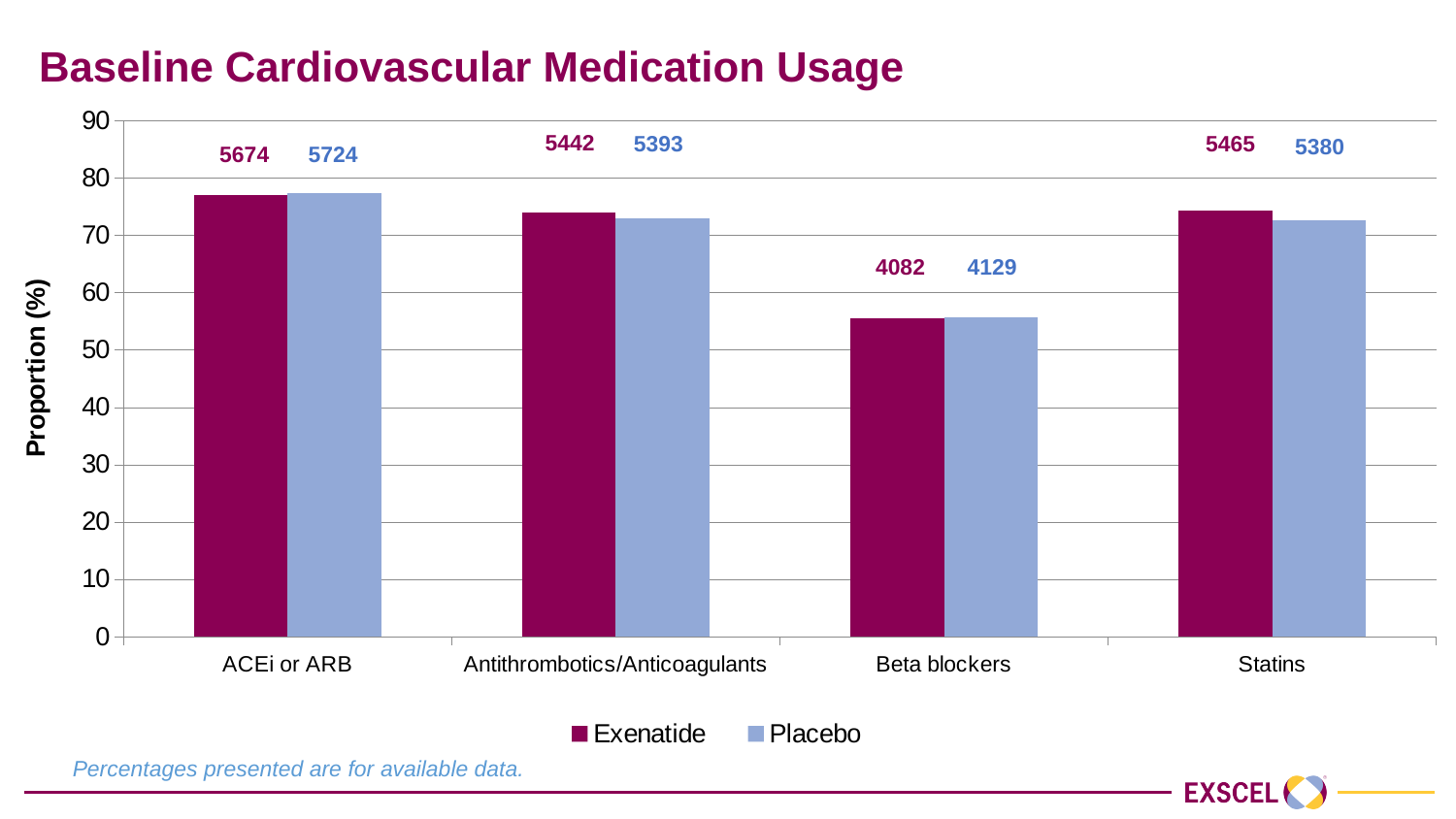
What is the title of the chart? Baseline Cardiovascular Medication Usage What number is printed above the Exenatide bar for ACEi or ARB? 5674 Is the Placebo proportion for ACEi or ARB greater or less than 70? greater Which category has the lowest proportion for the Exenatide series? Beta blockers How many medication categories are shown on the x axis? 4 Is the Exenatide proportion for Beta blockers greater or less than 60? less What number is printed above the Exenatide bar for Statins? 5465 What is the label on the y axis? Proportion (%) Which category has the highest proportion for the Placebo series? ACEi or ARB What kind of chart is shown on the slide? bar chart How many series does the legend list? 2 What number is printed above the Placebo bar for Beta blockers? 4129